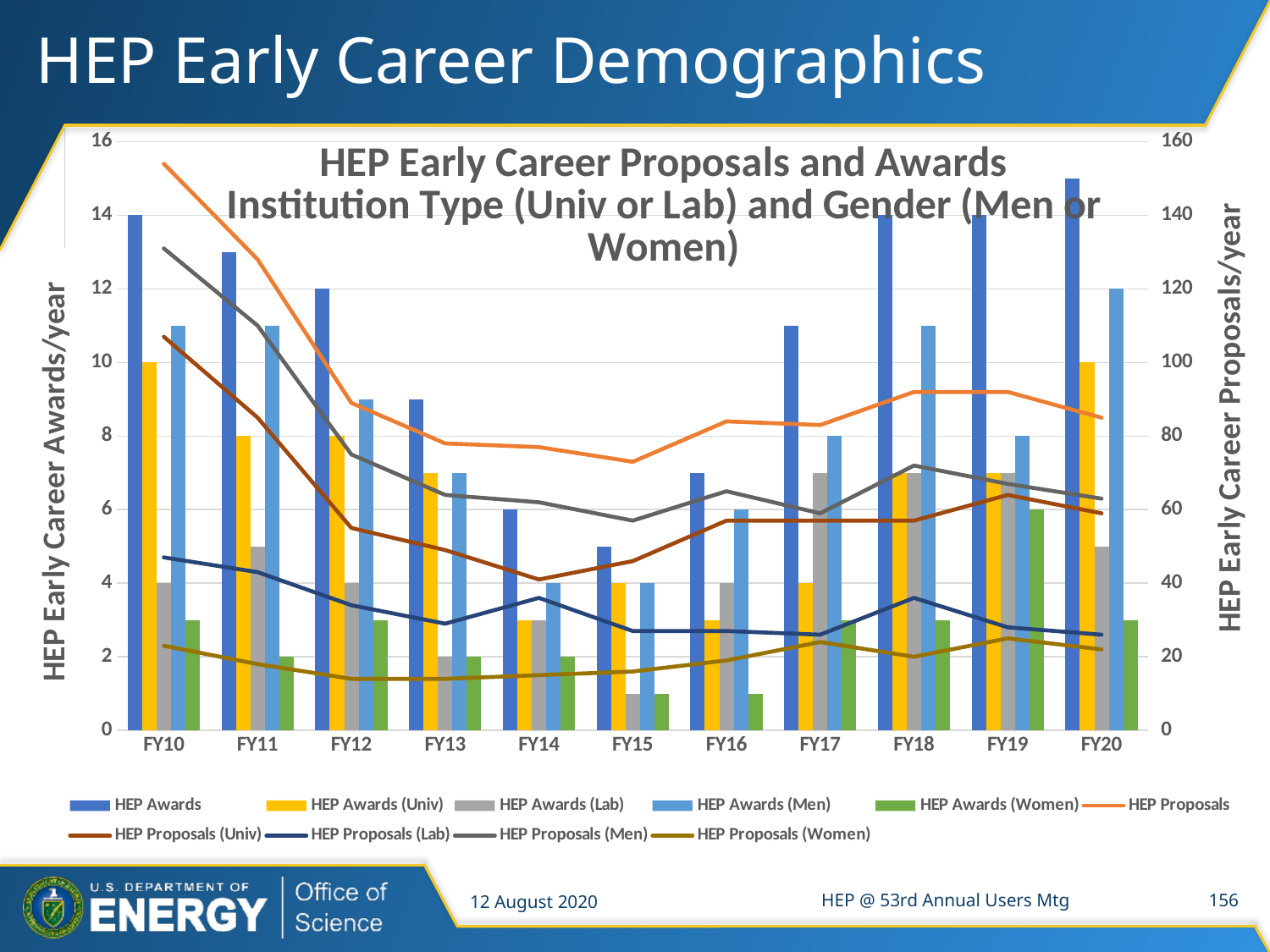
In which fiscal year is the HEP Proposals line highest? FY10 Is the value of HEP Proposals in FY15 greater or less than 80? less In which fiscal year is HEP Awards (Women) highest? FY19 What is the value of HEP Awards in FY10? 14 How many series does the legend list? 10 Is the value of HEP Proposals (Men) in FY10 greater or less than 120? greater What is the value of HEP Awards (Women) in FY19? 6 What type of chart is shown on the slide? Combined bar and line chart How many fiscal years are shown on the x axis? 11 What is the value of HEP Awards (Univ) in FY20? 10 What is the difference between HEP Awards and HEP Awards (Univ) in FY10? 4 What is the value of HEP Awards (Men) in FY20? 12